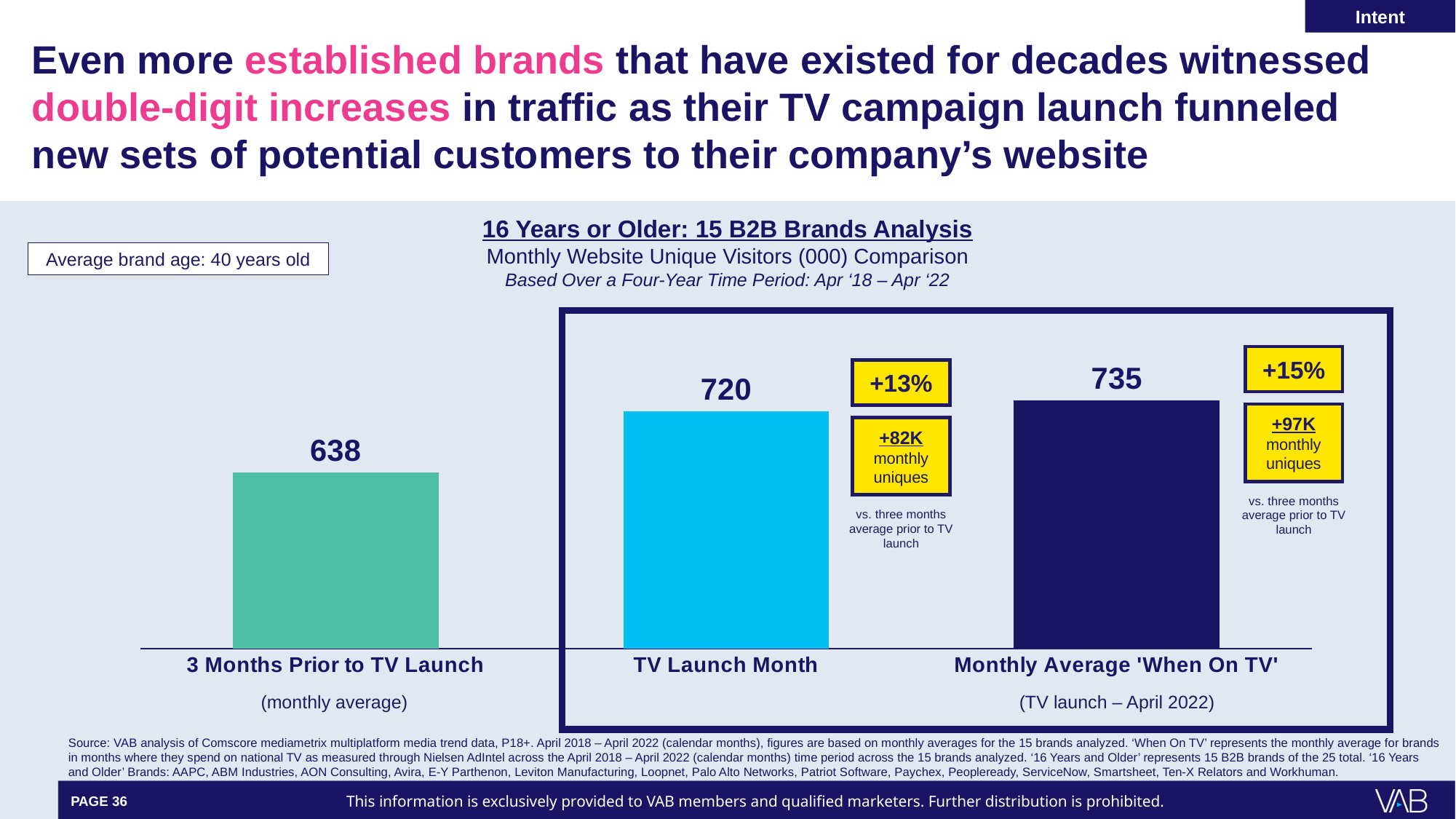
What is the difference between the 'TV Launch Month' value and the '3 Months Prior to TV Launch' value? 82 What is the value for 'TV Launch Month'? 720 What is the value for "Monthly Average 'When On TV'"? 735 Do the values rise or fall from left to right across the categories? Rise Which category has the highest value? Monthly Average 'When On TV' Which category has the lowest value? 3 Months Prior to TV Launch What is the value for '3 Months Prior to TV Launch'? 638 How many bars are shown in the chart? 3 Which is larger, the value for 'TV Launch Month' or the value for '3 Months Prior to TV Launch'? TV Launch Month What percentage increase is shown in the callout next to the 'TV Launch Month' bar? +13% What kind of chart is shown on the slide? Bar chart What is the difference between the "Monthly Average 'When On TV'" value and the '3 Months Prior to TV Launch' value? 97